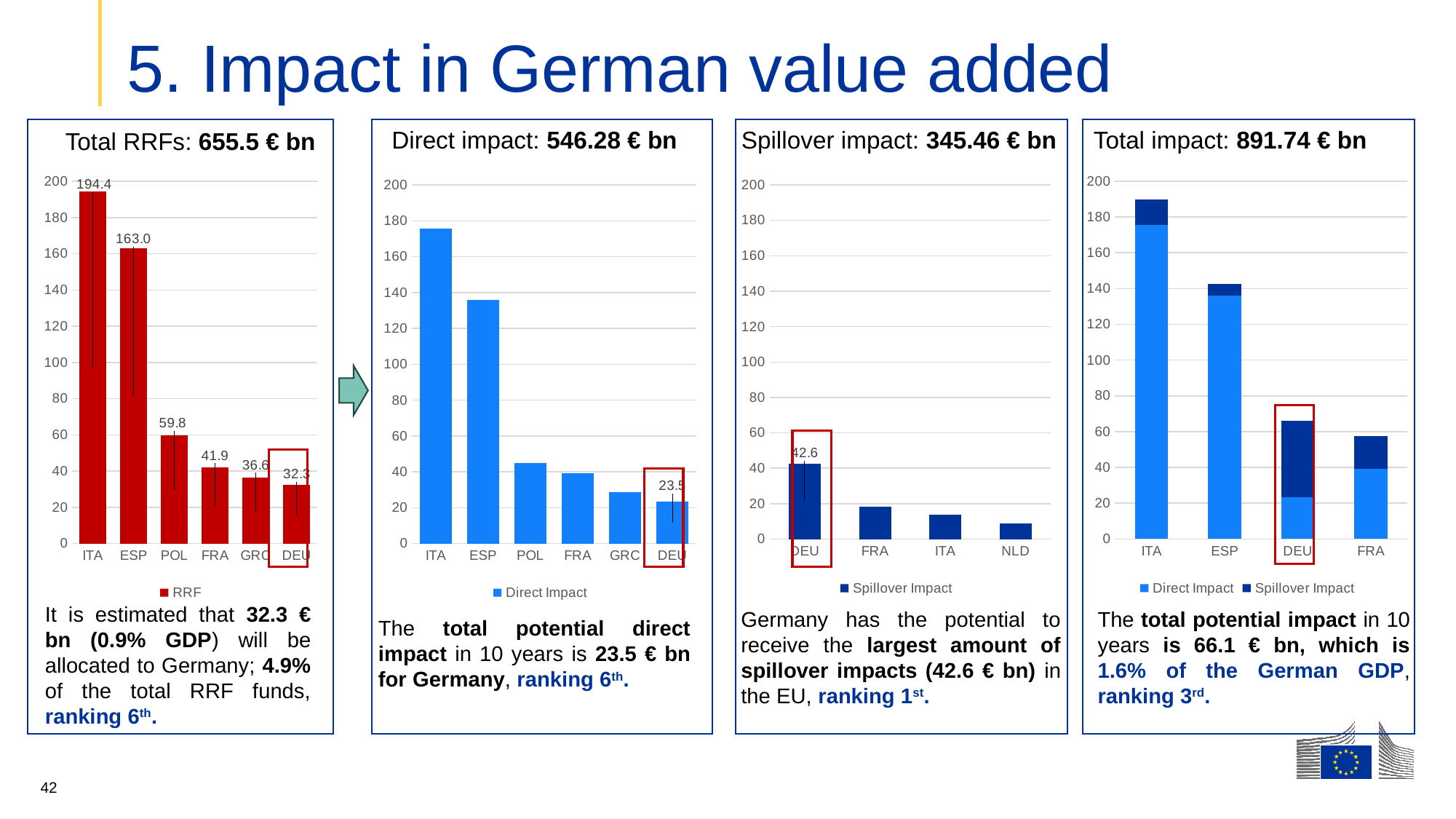
In the 'Total RRFs: 655.5 € bn' chart, what is the value for ITA? 194.4 In the 'Direct impact: 546.28 € bn' chart, is the value for ITA greater or less than 160? greater In the 'Total RRFs: 655.5 € bn' chart, which category has the highest value? ITA How many categories are shown in the 'Total RRFs: 655.5 € bn' chart? 6 In the 'Total RRFs: 655.5 € bn' chart, which category has the lowest value? DEU In the 'Direct impact: 546.28 € bn' chart, what is the value for DEU? 23.5 In the 'Total RRFs: 655.5 € bn' chart, what is the difference between the values for ITA and ESP? 31.4 In the 'Spillover impact: 345.46 € bn' chart, do the values rise or fall from left to right along the x axis? fall In the 'Total RRFs: 655.5 € bn' chart, what is the value for DEU? 32.3 In the 'Direct impact: 546.28 € bn' chart, which is larger, the value for ESP or the value for POL? ESP How many series does the legend of the 'Total impact: 891.74 € bn' chart list? 2 In the 'Spillover impact: 345.46 € bn' chart, what is the value for DEU? 42.6